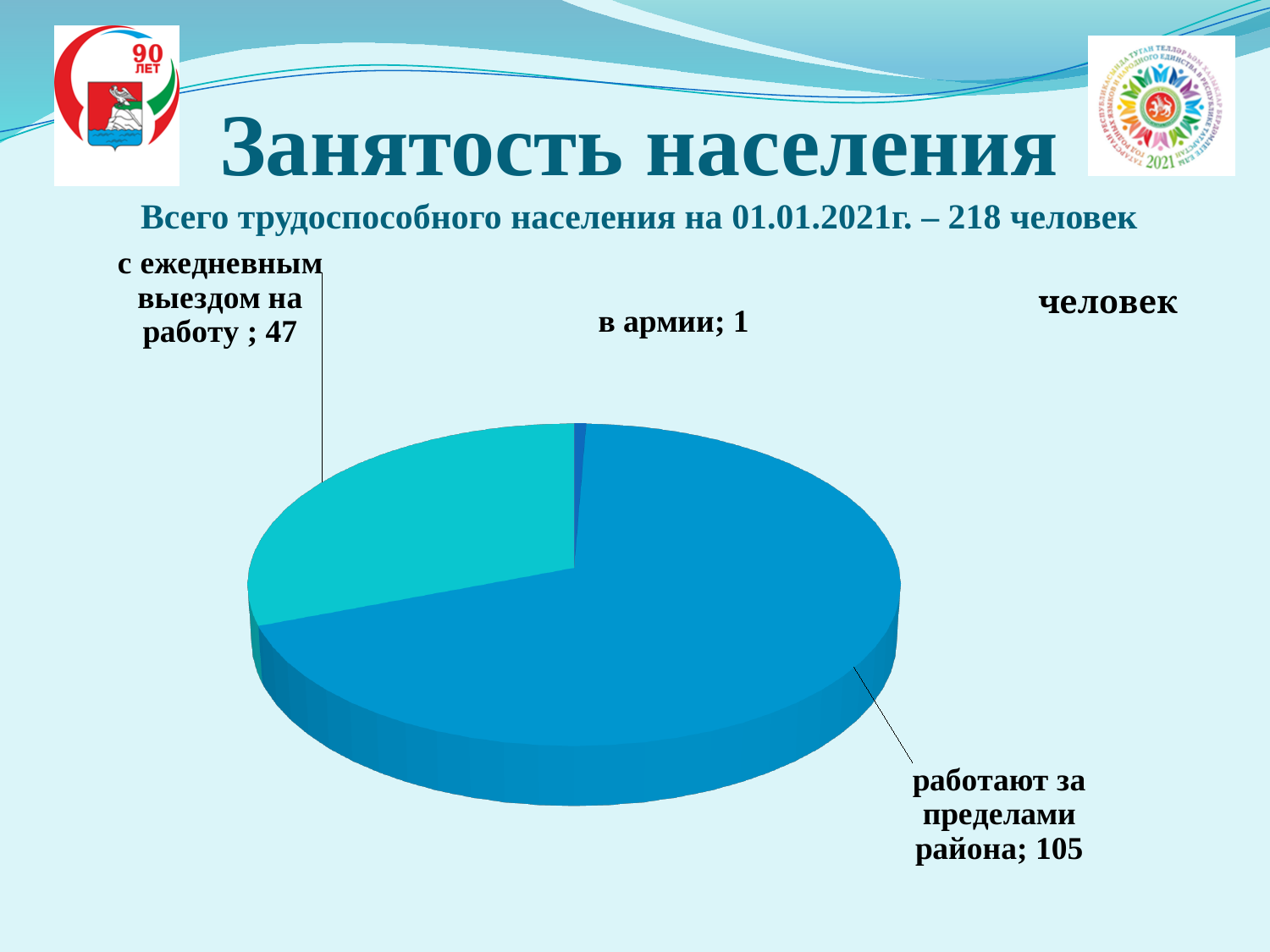
What is the difference between 'работают за пределами района' and 'с ежедневным выездом на работу'? 58 How many categories are shown in the pie chart? 3 What is the title of the slide containing the chart? Занятость населения Which category has the largest slice of the pie? работают за пределами района Which is larger: 'с ежедневным выездом на работу' or 'в армии'? с ежедневным выездом на работу What is the difference between 'с ежедневным выездом на работу' and 'в армии'? 46 What kind of chart is shown on the slide? pie chart Which category has the smallest slice of the pie? в армии How many people are in the category 'в армии'? 1 What is the sum of the three labeled slice values in the pie chart? 153 How many people are in the category 'работают за пределами района'? 105 How many people are in the category 'с ежедневным выездом на работу'? 47